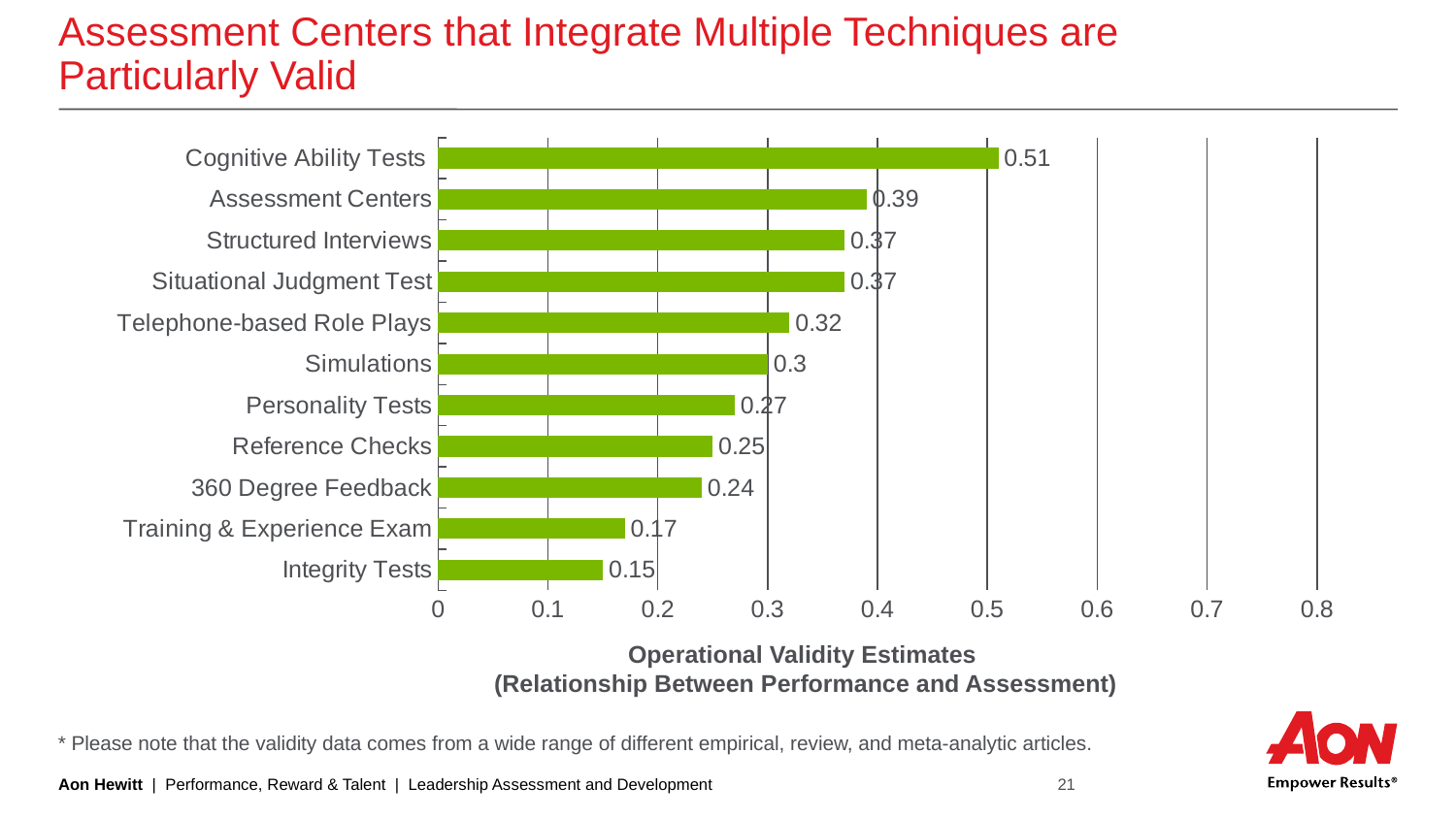
Which category has the highest operational validity estimate? Cognitive Ability Tests What is the value shown for Telephone-based Role Plays? 0.32 What is the title of the x axis of the chart? Operational Validity Estimates (Relationship Between Performance and Assessment) What is the difference between the values for Cognitive Ability Tests and Assessment Centers? 0.12 Is the value for Structured Interviews greater or less than 0.4? less Which has a larger value, Personality Tests or Reference Checks? Personality Tests What kind of chart is shown on the slide? Bar chart What is the difference between the values for Simulations and Integrity Tests? 0.15 What is the operational validity estimate for Assessment Centers? 0.39 How many categories are shown in the chart? 11 What is the value shown for 360 Degree Feedback? 0.24 Which category has the lowest operational validity estimate? Integrity Tests